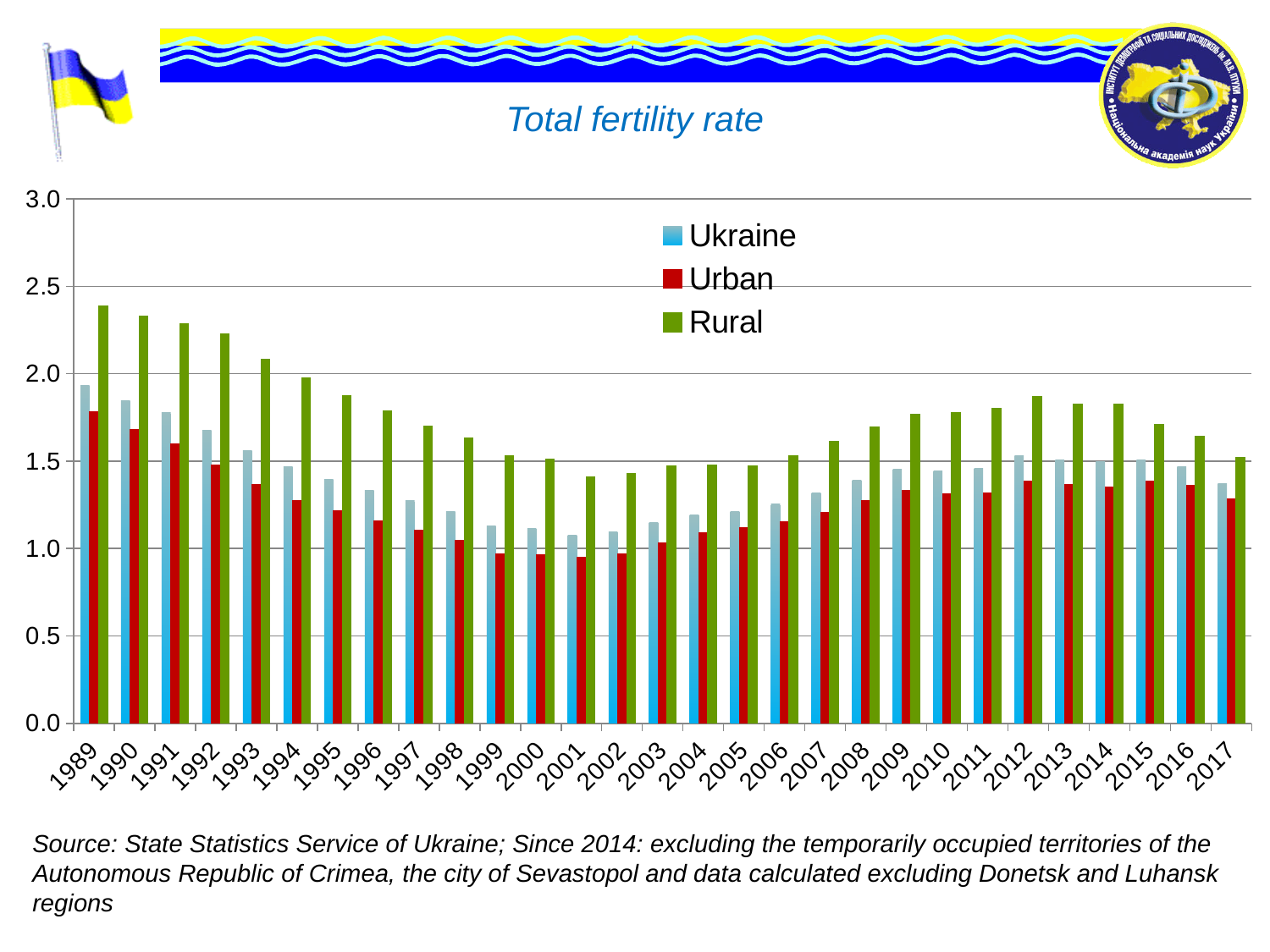
How many series does the legend list? 3 How many years are shown on the x axis? 29 Which is larger in 2017, the Rural value or the Urban value? Rural Which series is shown in green? Rural Does the Ukraine value rise or fall from 1989 to 2001? fall What kind of chart is shown on the slide? bar chart In which year is the Ukraine value highest? 1989 What is the title of the chart? Total fertility rate Is the Rural value for 2001 greater or less than 1.5? less In which year is the Rural value highest? 1989 Is the Rural value for 1989 greater or less than 2.0? greater Is the Urban value for 2001 greater or less than 1.0? less